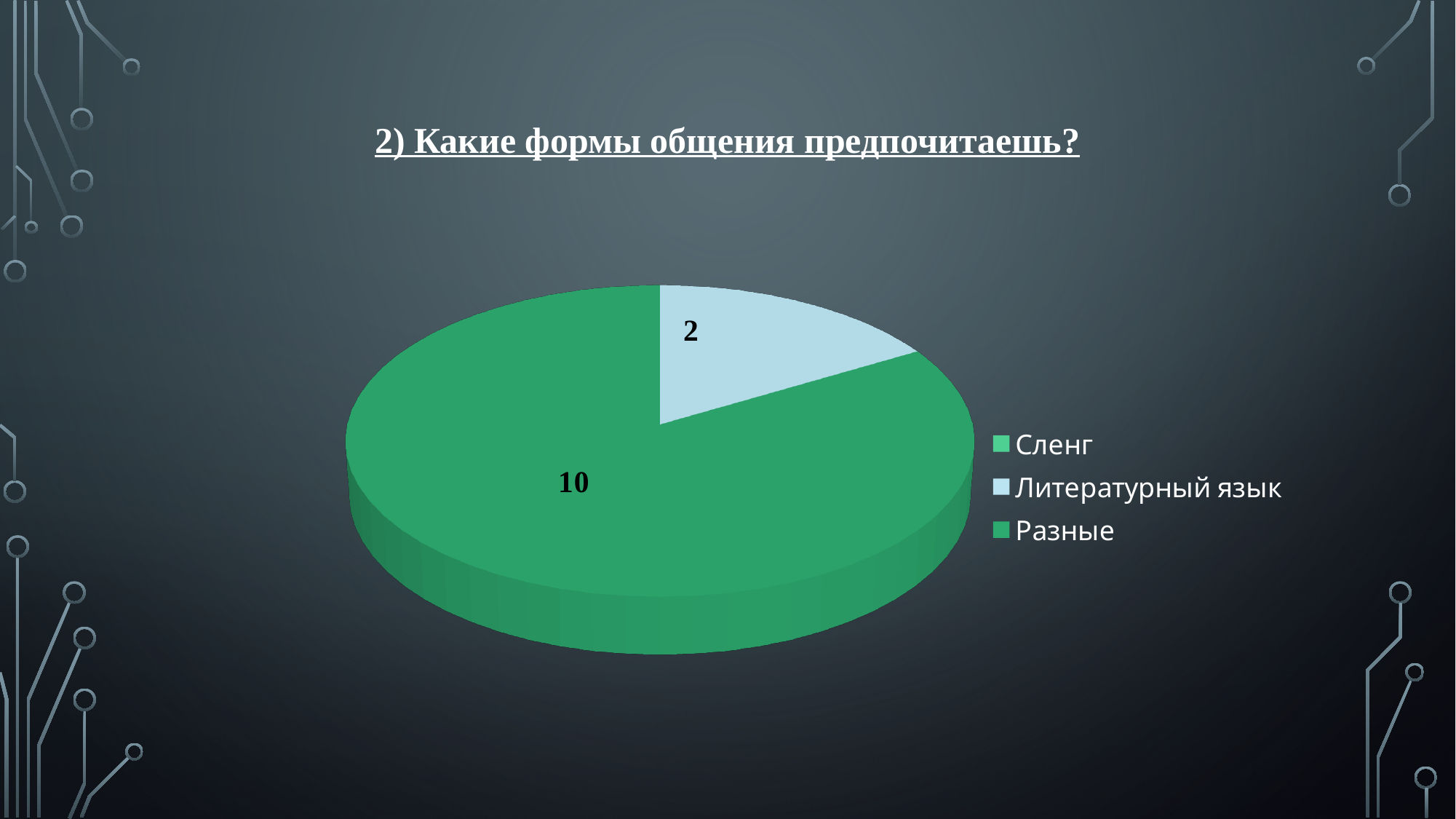
What is the difference between the two labelled slice values, 10 and 2? 8 What type of chart is shown on the slide? pie chart What is the title of the chart? 2) Какие формы общения предпочитаешь? What value is shown for the Литературный язык slice? 2 How many entries does the chart legend list? 3 What colour is the Литературный язык slice? light blue Is the Литературный язык slice larger or smaller than the green slice labelled 10? smaller What value is shown on the smallest slice of the pie? 2 How many slices with data labels are visible in the pie chart? 2 What is the total of the two labelled slice values? 12 What value is shown on the largest slice of the pie? 10